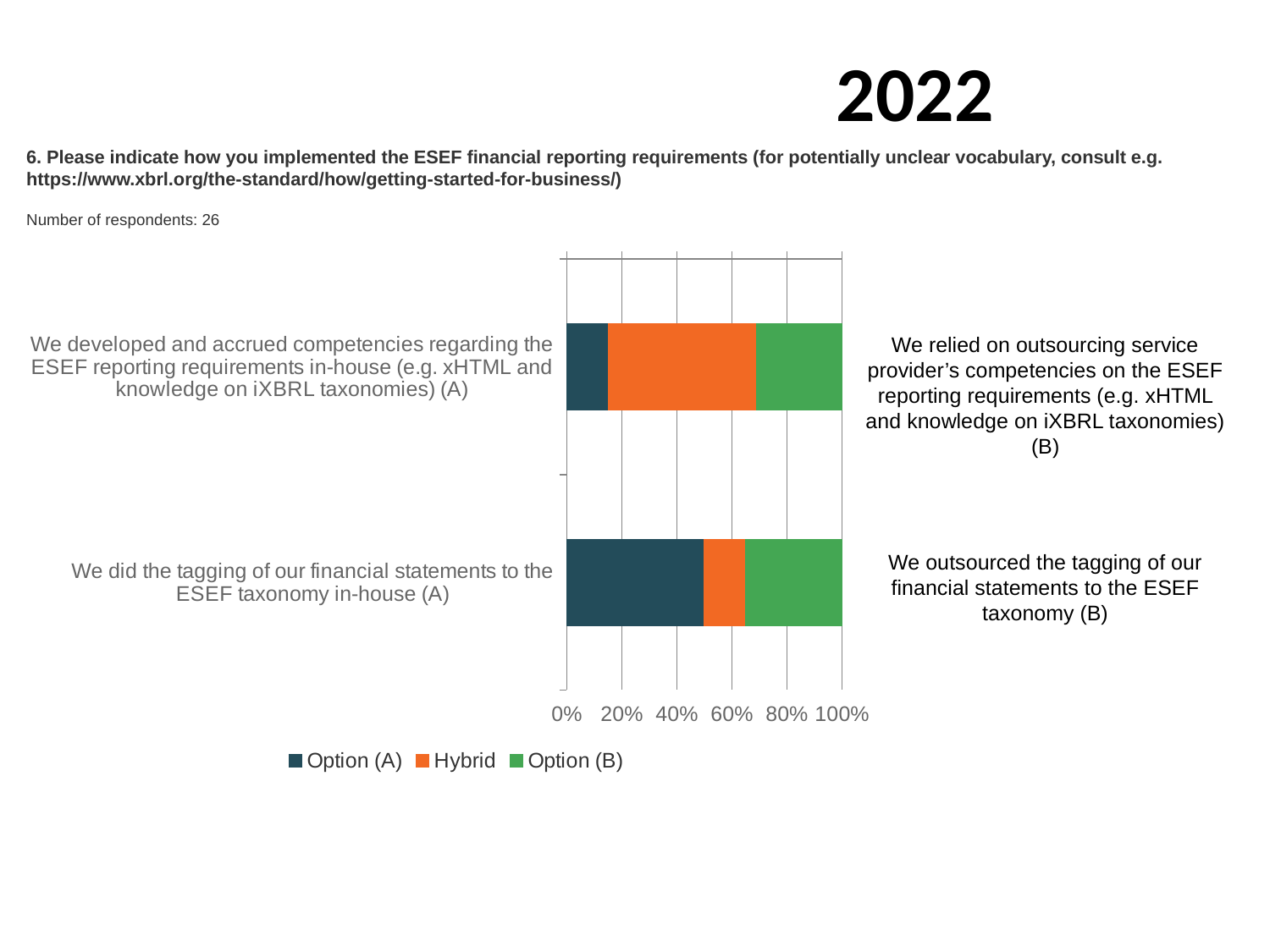
Is the Option (A) share for the bar about developing competencies in-house greater or less than 20%? less Is the Hybrid share larger for the competencies bar or for the tagging bar? Competencies bar What are the three series named in the legend? Option (A), Hybrid, Option (B) Which series has the largest segment in the bar about developing competencies in-house? Hybrid Which colour represents the Hybrid series in the chart? Orange How many categories (bars) are plotted in the chart? 2 Is the Hybrid share for the bar about developing competencies in-house greater or less than 40%? greater Is the Hybrid share for the bar about tagging financial statements greater or less than 20%? less Which series has the largest segment in the bar about tagging financial statements? Option (A) What kind of chart is shown on the slide? Stacked bar chart How many series does the legend list? 3